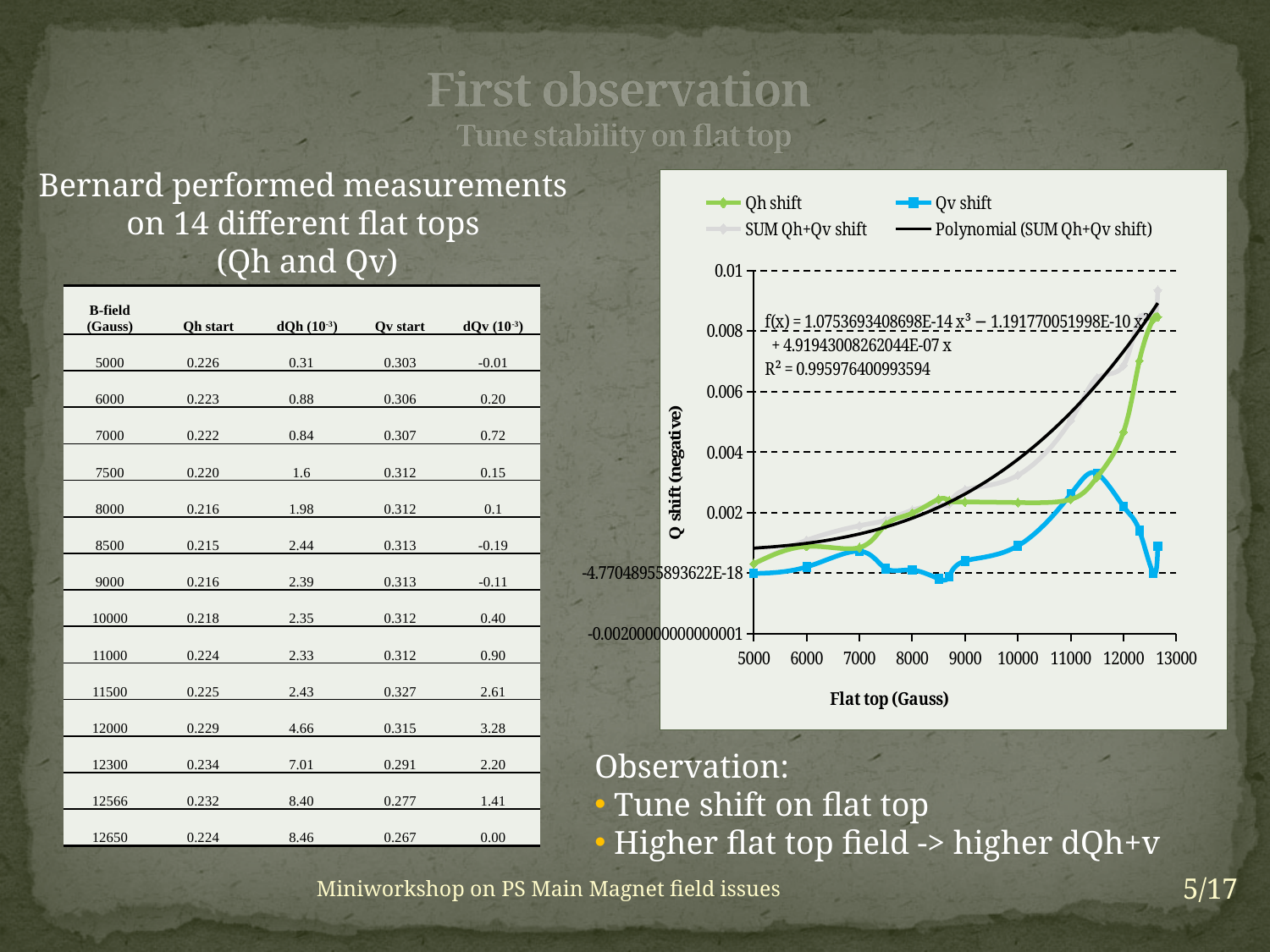
How many series does the chart legend list? 4 At which flat top value does the Qv shift series reach its highest point? 11500 What R² value is printed on the chart for the polynomial fit? 0.995976400993594 Is the Qv shift value at a flat top of 8500 Gauss greater or less than 0.002? less Is the Qh shift value at a flat top of 5000 Gauss greater or less than 0.002? less Does the Polynomial (SUM Qh+Qv shift) curve rise or fall as the flat top increases from 5000 to 13000 Gauss? rise At a flat top of 12650 Gauss, which series has the larger value, Qh shift or Qv shift? Qh shift Is the Qh shift value at a flat top of 12650 Gauss greater or less than 0.006? greater What kind of chart is shown on the slide? line chart What is the title of the y axis of the chart? Q shift (negative) What is the title of the x axis of the chart? Flat top (Gauss)